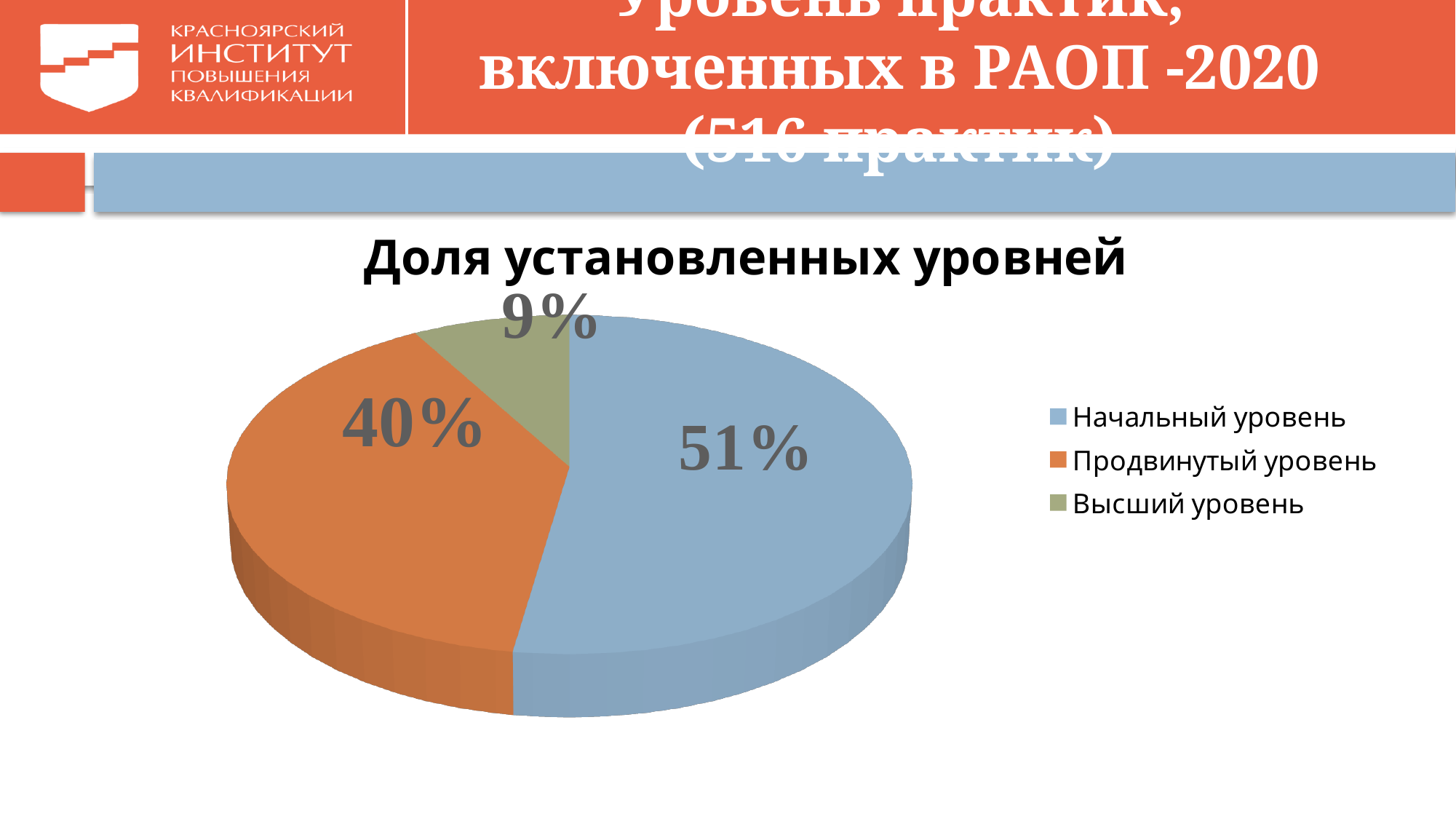
Which is larger: the share of Продвинутый уровень or the share of Высший уровень? Продвинутый уровень What share of the pie does Продвинутый уровень have? 40% What is the chart's title? Доля установленных уровней Which colour represents Продвинутый уровень in the legend? orange What share of the pie does Начальный уровень have? 51% What is the difference between the shares of Начальный уровень and Продвинутый уровень? 11% What share of the pie does Высший уровень have? 9% What is the difference between the shares of Продвинутый уровень and Высший уровень? 31% Which category has the largest slice of the pie? Начальный уровень How many categories does the pie chart have? 3 What type of chart is shown on the slide? pie chart Which category has the smallest slice of the pie? Высший уровень